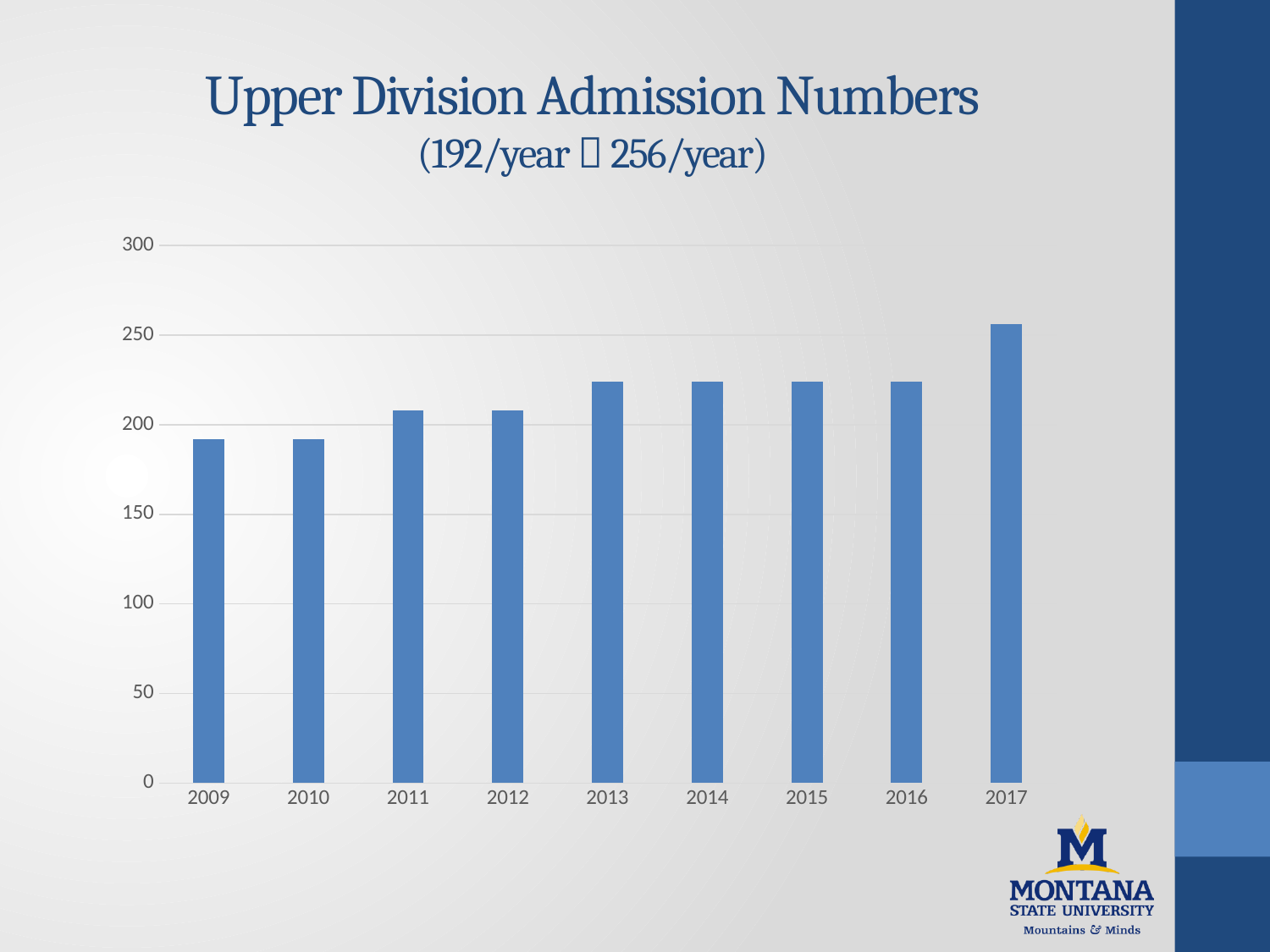
Is the value for 2011 greater or less than 200? greater Which is larger, the value for 2017 or the value for 2013? 2017 Is the value for 2009 greater or less than 200? less How many years are shown on the x axis of the chart? 9 Is the value for 2017 greater or less than 250? greater What is the title of the chart on the slide? Upper Division Admission Numbers Do the values generally rise or fall from 2009 to 2017? rise Which year has the highest bar in the chart? 2017 What kind of chart is shown on the slide? bar chart Which is larger, the value for 2011 or the value for 2009? 2011